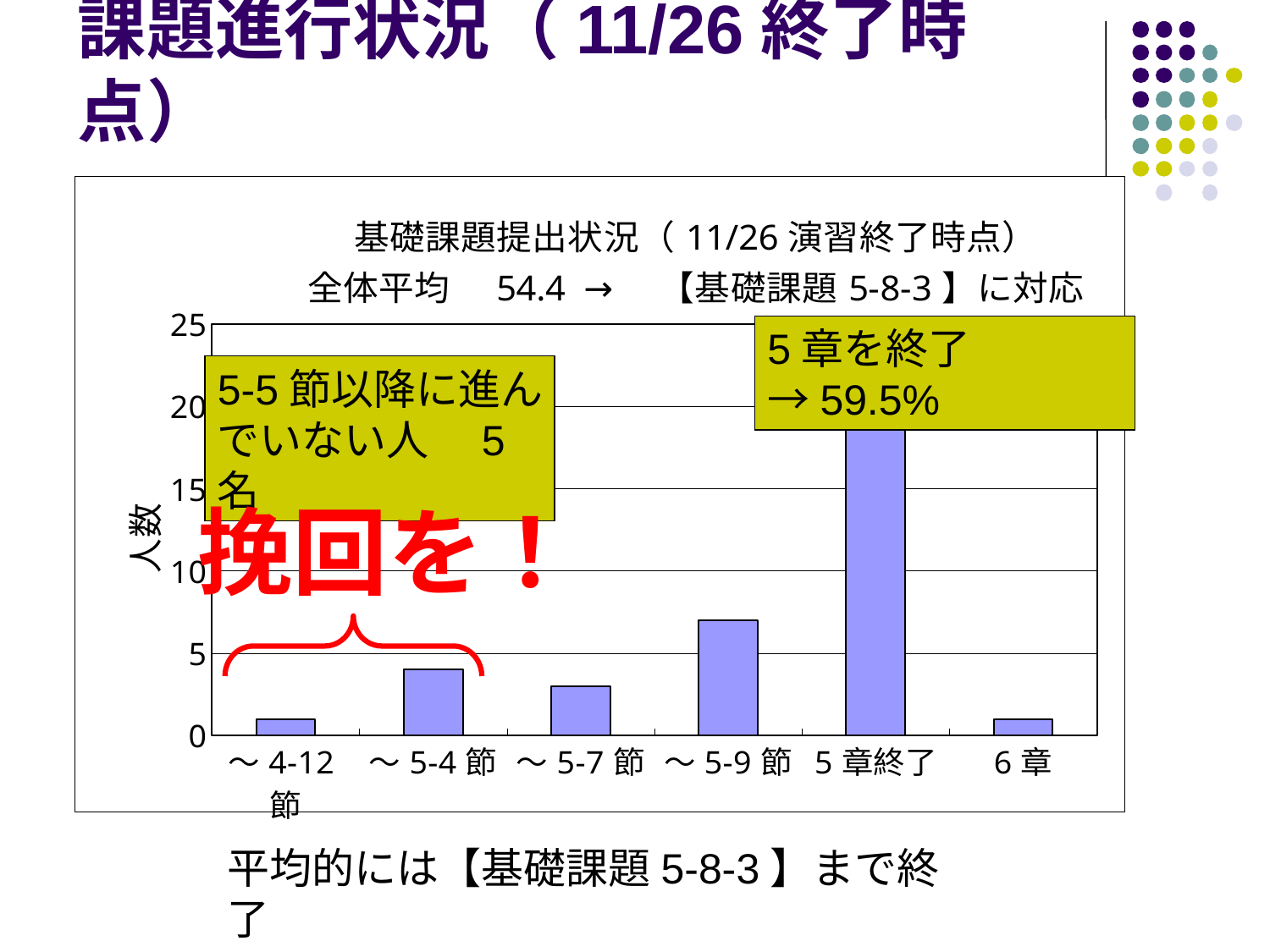
What is the title of the chart? 基礎課題提出状況（11/26演習終了時点） 全体平均 54.4 → 【基礎課題5-8-3】に対応 Is the value for ～5-9節 greater or less than 5? greater Is the value for 6章 greater or less than 5? less Which category has the highest value in the chart? 5章終了 Which is larger, the value for 5章終了 or the value for ～5-9節? 5章終了 Which is larger, the value for ～5-9節 or the value for ～5-4節? ～5-9節 What is the label of the vertical axis of the chart? 人数 What kind of chart is shown on the slide? bar chart Is the value for ～5-7節 greater or less than 5? less How many categories are shown on the x axis of the chart? 6